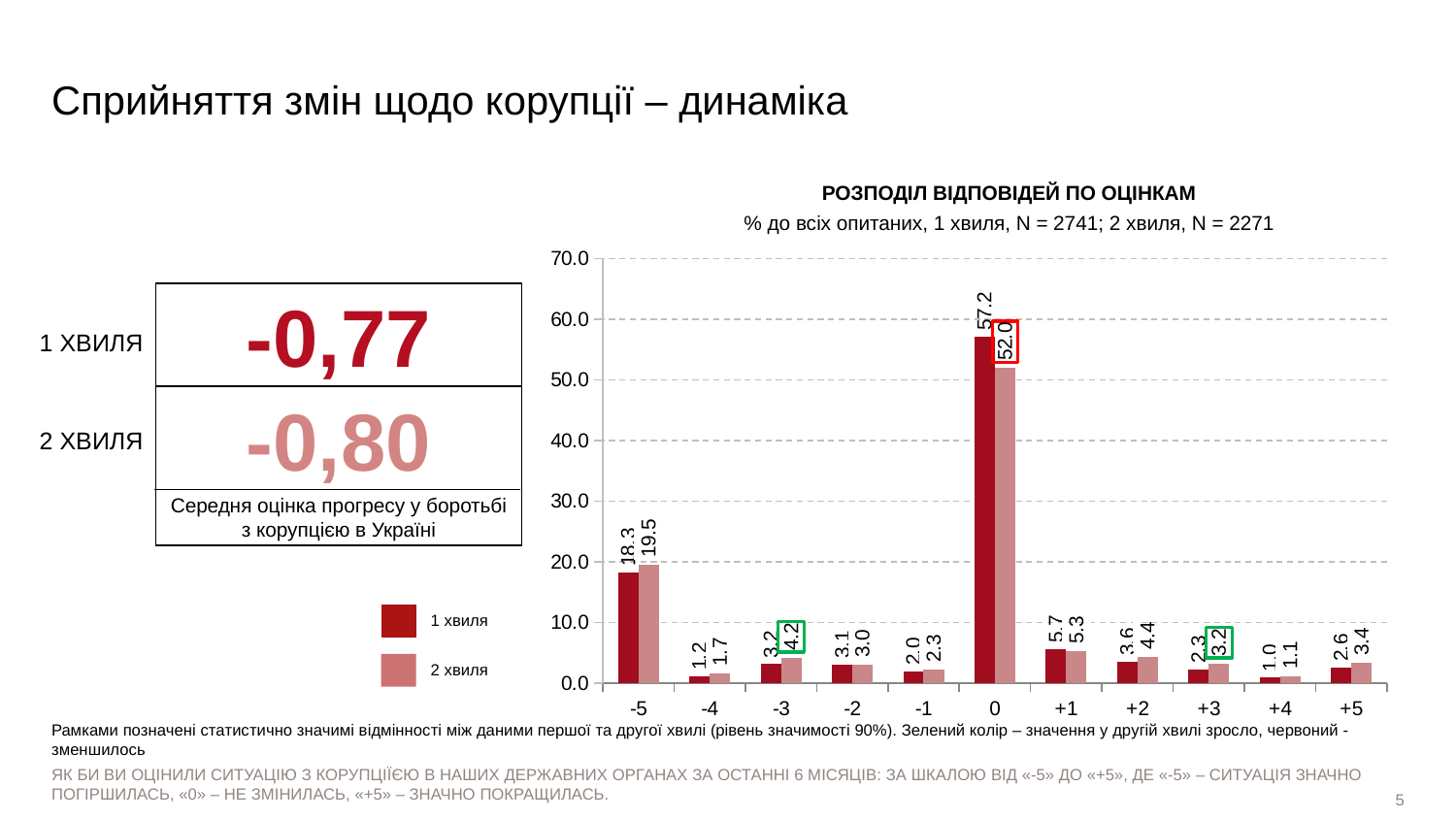
What is the value for category 0 in the 1 хвиля series? 57.2 Which category has the highest value in the 1 хвиля series? 0 How many categories are shown on the x axis? 11 Which category has the lowest value in the 2 хвиля series? +4 Which is larger for category +2: the 1 хвиля value or the 2 хвиля value? 2 хвиля How many series does the legend list? 2 What is the value for category 0 in the 2 хвиля series? 52.0 What is the value for category +1 in the 1 хвиля series? 5.7 Is the value for category -5 in the 1 хвиля series greater or less than 20.0? less What is the difference between the 1 хвиля and 2 хвиля values for category 0? 5.2 What is the value for category -5 in the 2 хвиля series? 19.5 What kind of chart is shown on the slide? bar chart